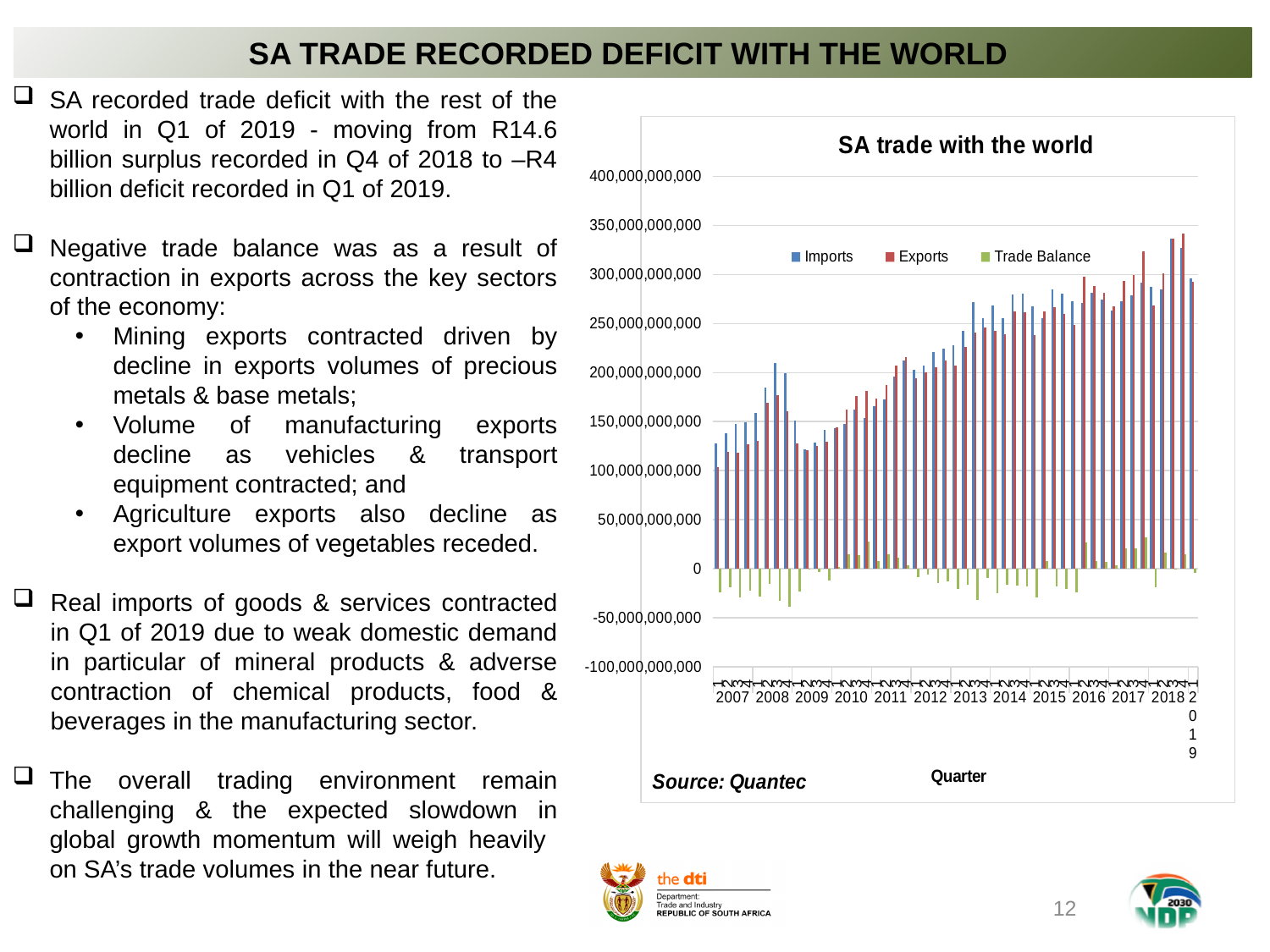
Is the Imports value in the fourth quarter of 2018 greater or less than 300,000,000,000? greater Which series has the smallest values throughout the chart? Trade Balance Is the Imports value in the second quarter of 2008 greater or less than 150,000,000,000? greater What kind of chart is shown on the slide? Bar chart Do the Imports values generally rise or fall from 2007 to 2018? Rise What are the three series named in the chart's legend? Imports, Exports, Trade Balance How many series does the chart's legend list? 3 What is the title of the chart? SA trade with the world Is the Trade Balance value in 2009 greater or less than 50,000,000,000? less In 2008, which series is larger, Imports or Exports? Imports How many years are labelled along the x axis of the chart? 13